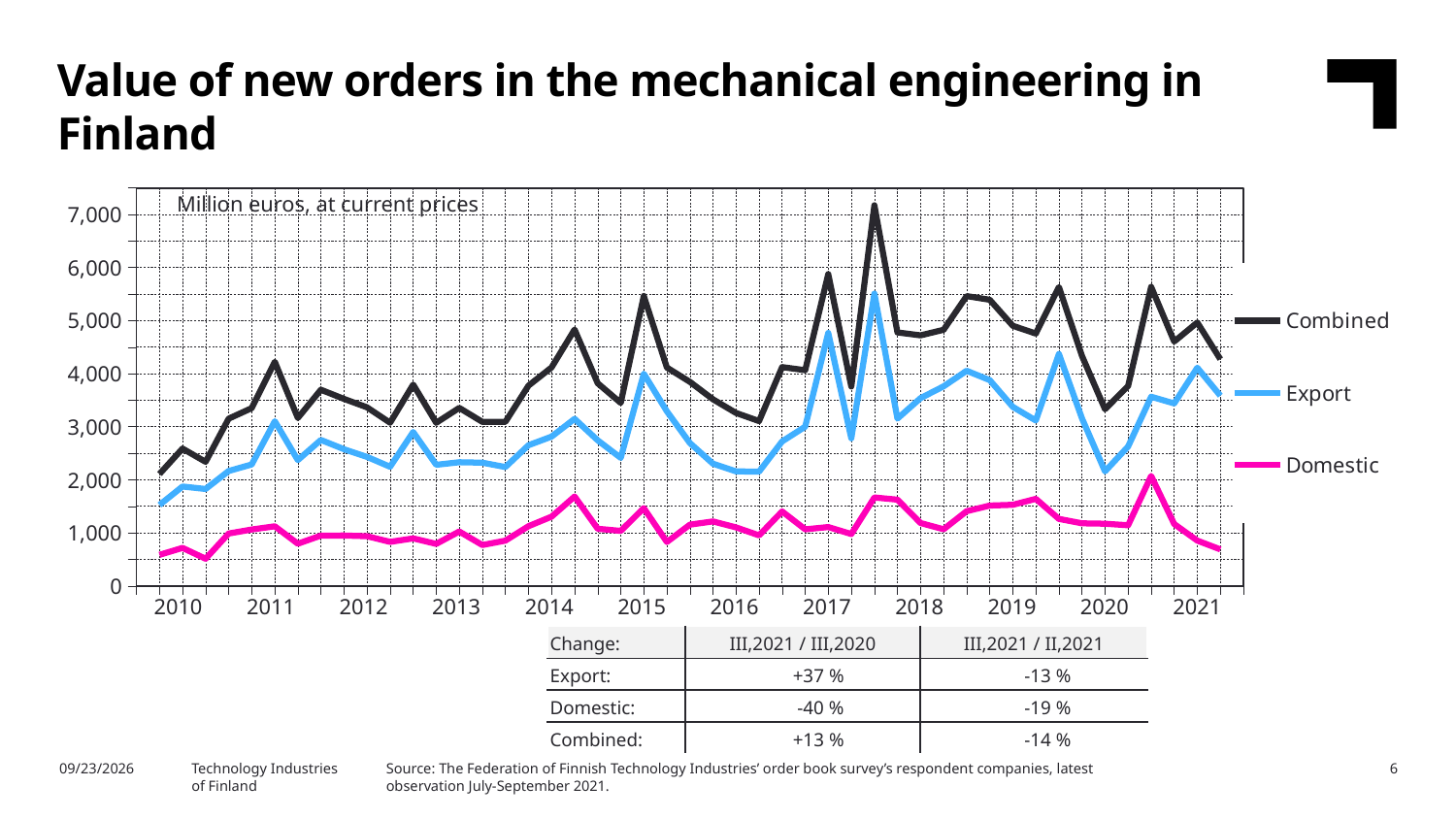
How many series does the legend list? 3 Which series is plotted with the highest values throughout the chart? Combined Which series is plotted with the lowest values throughout the chart? Domestic Which series has the larger value in 2021, Export or Domestic? Export Does the Combined series rise or fall from the start of 2010 to the start of 2011? rise Is the peak value of the Export series in 2017 greater or less than 5,000? greater How many year labels are shown on the x axis? 12 Is the peak value of the Combined series in 2017 greater or less than 6,000? greater What type of chart is shown on the slide? line chart Is the Domestic value at the start of 2010 greater or less than 1,000? less What unit is stated at the top of the chart area? Million euros, at current prices